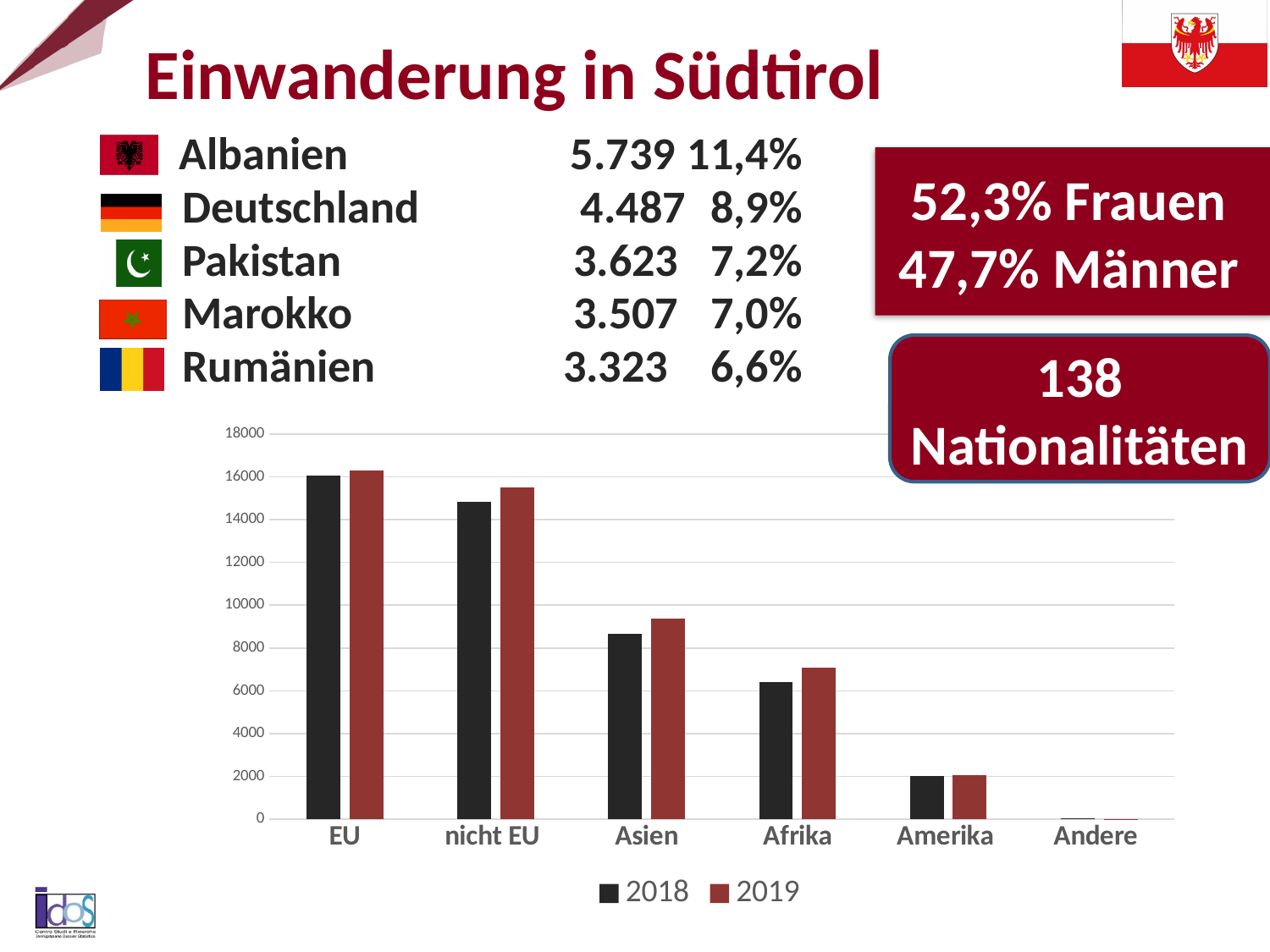
Which years are listed in the chart's legend? 2018 and 2019 Is the 2018 value for Amerika greater or less than 4000? less How many categories are shown on the x axis of the chart? 6 Do the bar values rise or fall moving from EU to Andere along the x axis? fall Which category has the lowest bars in the chart? Andere What kind of chart is shown on the slide? bar chart Is the 2019 value for Afrika greater or less than 6000? greater How many series does the chart's legend list? 2 Is the 2018 value for Asien greater or less than 10000? less Which is larger in 2019, the value for Asien or the value for Afrika? Asien Which category has the highest bars in the chart? EU